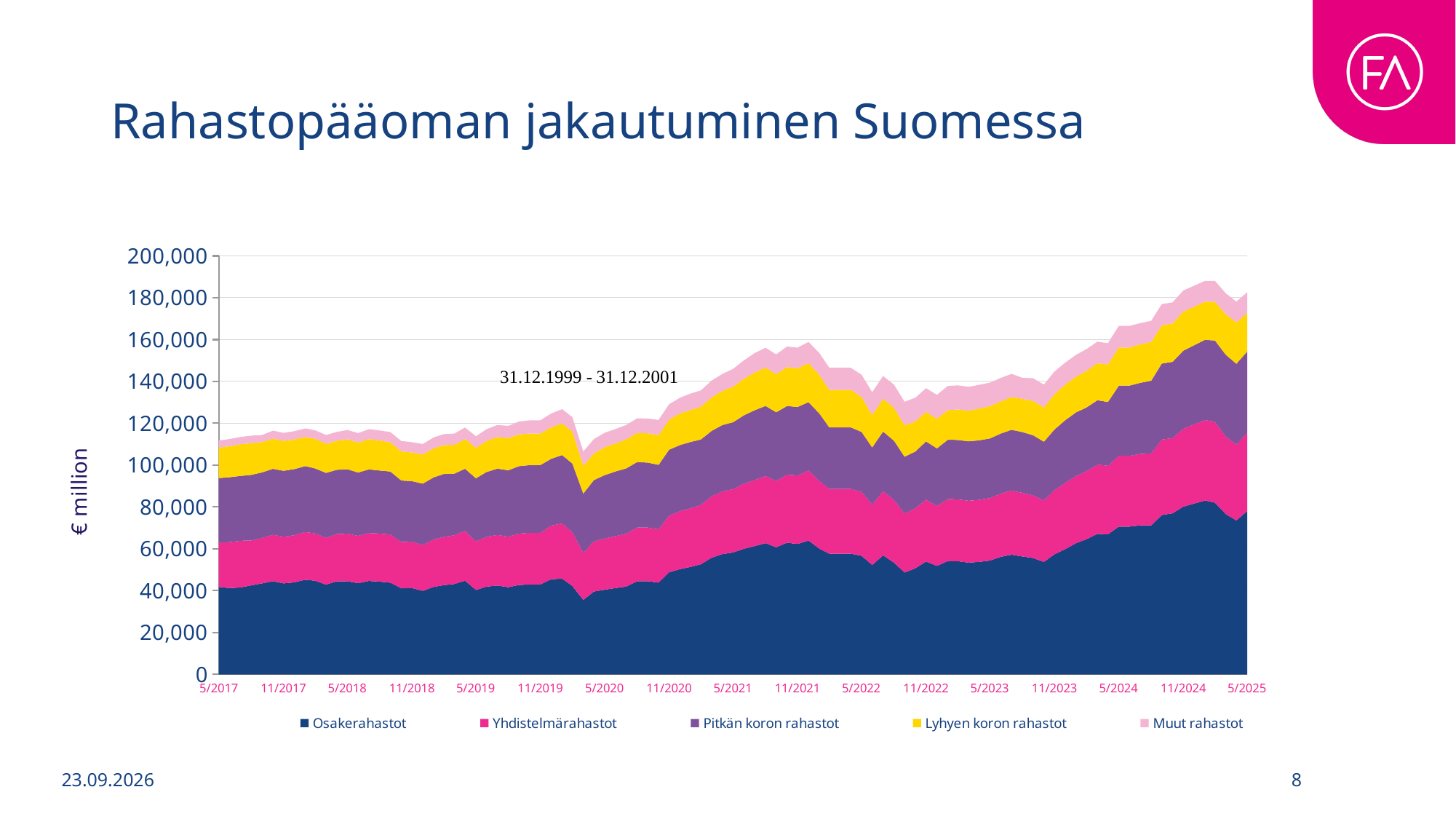
What is the label on the vertical axis of the chart? € million Is the total stacked value at 11/2024 greater or less than 160,000? greater What kind of chart is shown on the slide? Stacked area chart How many series does the legend list? 5 What is the title of the chart on the slide? Rahastopääoman jakautuminen Suomessa Is the total stacked value at 5/2017 greater or less than 100,000? greater How many date labels are shown along the x axis? 17 Is the total stacked value at 5/2020 greater or less than 120,000? less Does the total stacked value rise or fall overall from 5/2017 to 5/2025? rise Does the value for Osakerahastot rise or fall overall from 5/2017 to 5/2025? rise